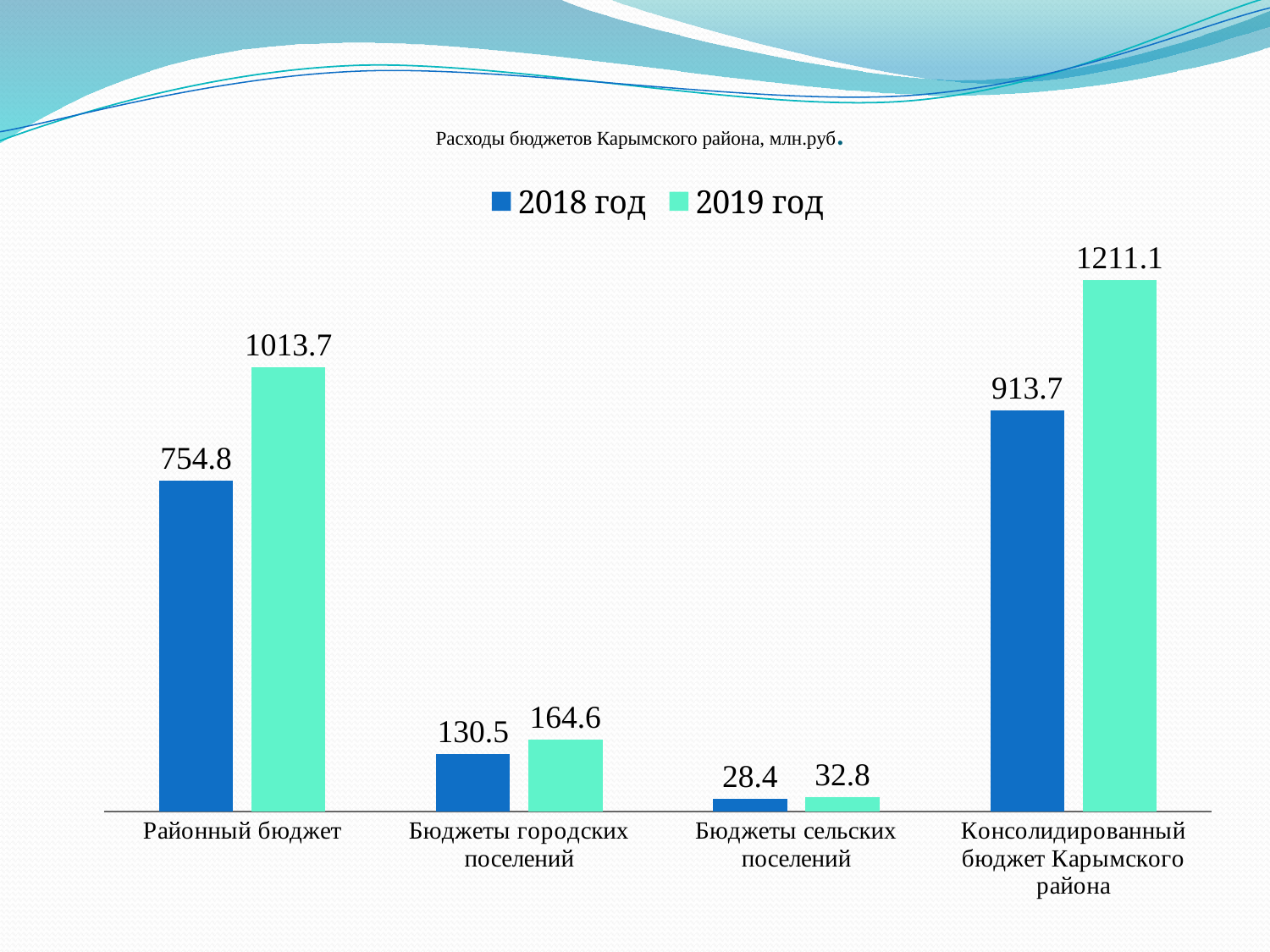
What is the value for Консолидированный бюджет Карымского района in 2019 год? 1211.1 What is the value for Бюджеты сельских поселений in 2018 год? 28.4 What is the difference between the 2019 год and 2018 год values for Бюджеты сельских поселений? 4.4 How many series does the legend list? 2 What kind of chart is shown on the slide? Bar chart What is the difference between the 2019 год and 2018 год values for Районный бюджет? 258.9 What is the value for Районный бюджет in 2018 год? 754.8 Which category has the lowest value in 2018 год? Бюджеты сельских поселений Which is larger for Бюджеты городских поселений: the 2018 год value or the 2019 год value? 2019 год What is the value for Бюджеты городских поселений in 2019 год? 164.6 Which category has the highest value in 2019 год? Консолидированный бюджет Карымского района How many categories are shown on the x axis? 4